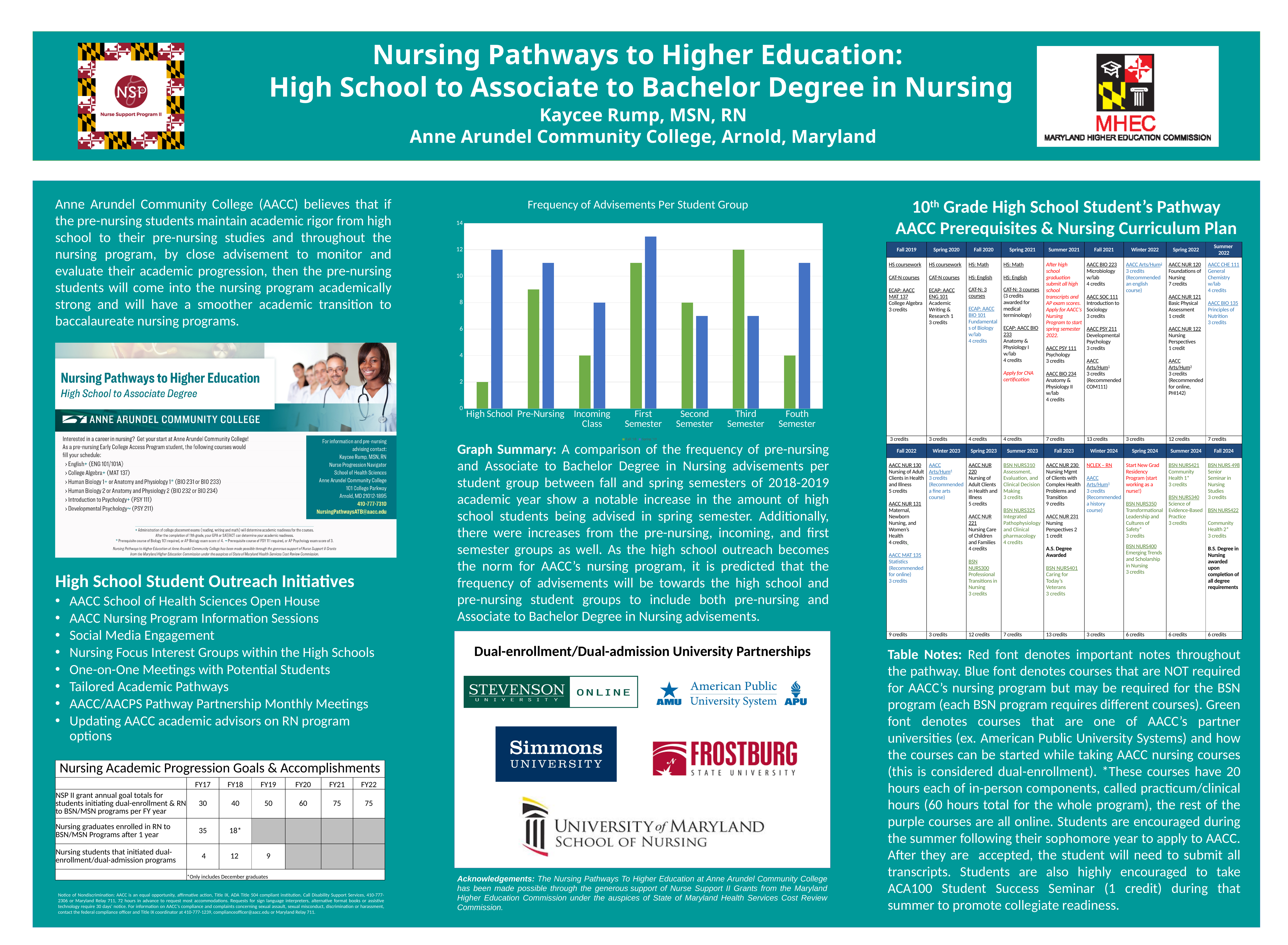
In the 'Frequency of Advisements Per Student Group' chart, which student group has the highest blue bar? First Semester In the 'Frequency of Advisements Per Student Group' chart, is the green bar for Pre-Nursing greater or less than 6? greater In the 'Frequency of Advisements Per Student Group' chart, which student group has the lowest green bar? High School In the 'Frequency of Advisements Per Student Group' chart, is the blue bar for High School greater or less than 10? greater What kind of chart is shown under the title 'Frequency of Advisements Per Student Group'? bar chart In the 'Frequency of Advisements Per Student Group' chart, for the Third Semester group, is the green bar or the blue bar larger? green What is the title of the chart in the middle column of the poster? Frequency of Advisements Per Student Group How many student group categories are shown on the x axis of the 'Frequency of Advisements Per Student Group' chart? 7 In the 'Frequency of Advisements Per Student Group' chart, for the High School group, is the green bar or the blue bar larger? blue In the 'Frequency of Advisements Per Student Group' chart, is the green bar for Incoming Class greater or less than 6? less